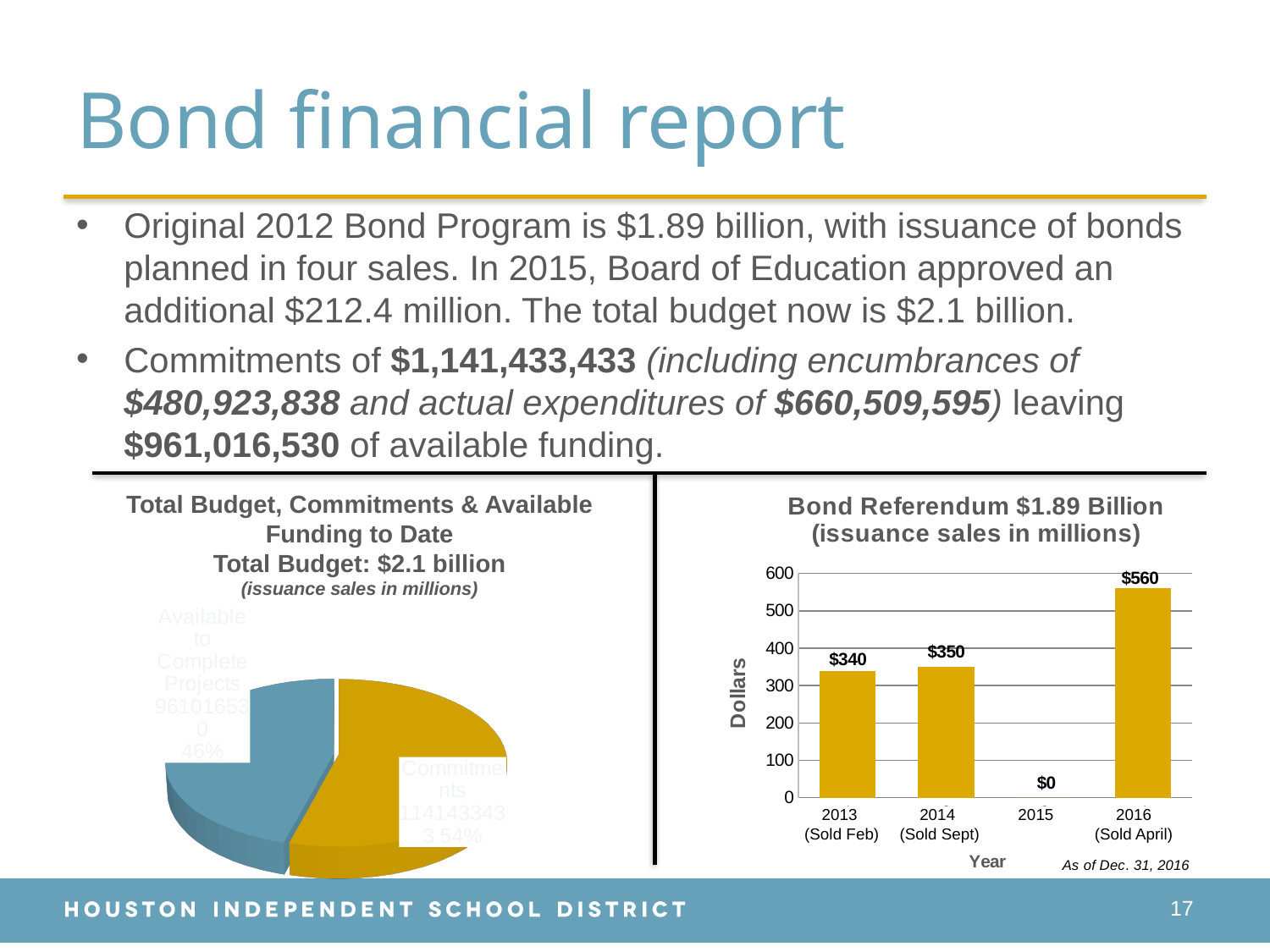
In the Bond Referendum $1.89 Billion chart, what is the value for 2014 (Sold Sept)? $350 In the Bond Referendum $1.89 Billion chart, what is the value for 2013 (Sold Feb)? $340 In the Bond Referendum $1.89 Billion chart, is the value for 2016 greater or less than 500? greater In the Bond Referendum $1.89 Billion chart, what is the value for 2015? $0 In the Bond Referendum $1.89 Billion chart, which year has the highest value? 2016 What kind of chart is the Bond Referendum $1.89 Billion chart on the right? bar chart In the Bond Referendum $1.89 Billion chart, what is the value for 2016 (Sold April)? $560 In the Bond Referendum $1.89 Billion chart, which year has the lowest value? 2015 In the Bond Referendum $1.89 Billion chart, what is the difference between the 2016 and 2014 values? $210 How many years are shown on the x axis of the Bond Referendum $1.89 Billion chart? 4 In the Bond Referendum $1.89 Billion chart, which is larger, the value for 2013 or for 2014? 2014 What kind of chart is the Total Budget, Commitments & Available Funding to Date chart on the left? pie chart